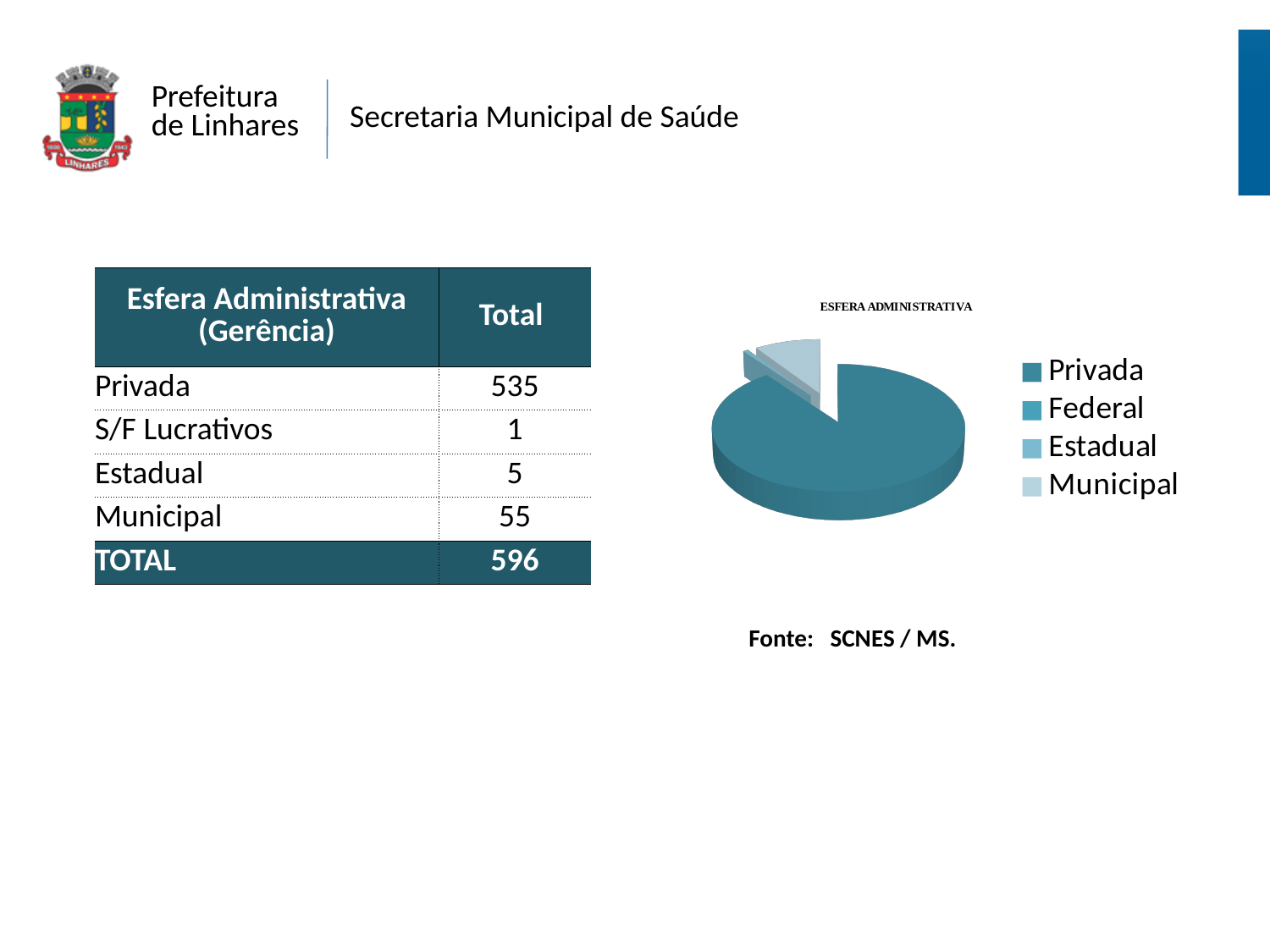
According to the table next to the pie chart, what is the total for Municipal? 55 Which slice is larger in the pie chart, Municipal or Estadual? Municipal According to the table next to the pie chart, what is the difference between the Privada and Municipal totals? 480 According to the table next to the pie chart, what is the overall TOTAL? 596 According to the table next to the pie chart, what is the total for Privada? 535 What is the title of the pie chart? ESFERA ADMINISTRATIVA What kind of chart is shown on the slide? pie chart Which slice is larger in the pie chart, Privada or Municipal? Privada Which category has the largest slice in the pie chart? Privada According to the table next to the pie chart, what is the total for Estadual? 5 Which legend entry is listed last in the pie chart's legend? Municipal How many entries does the pie chart's legend list? 4